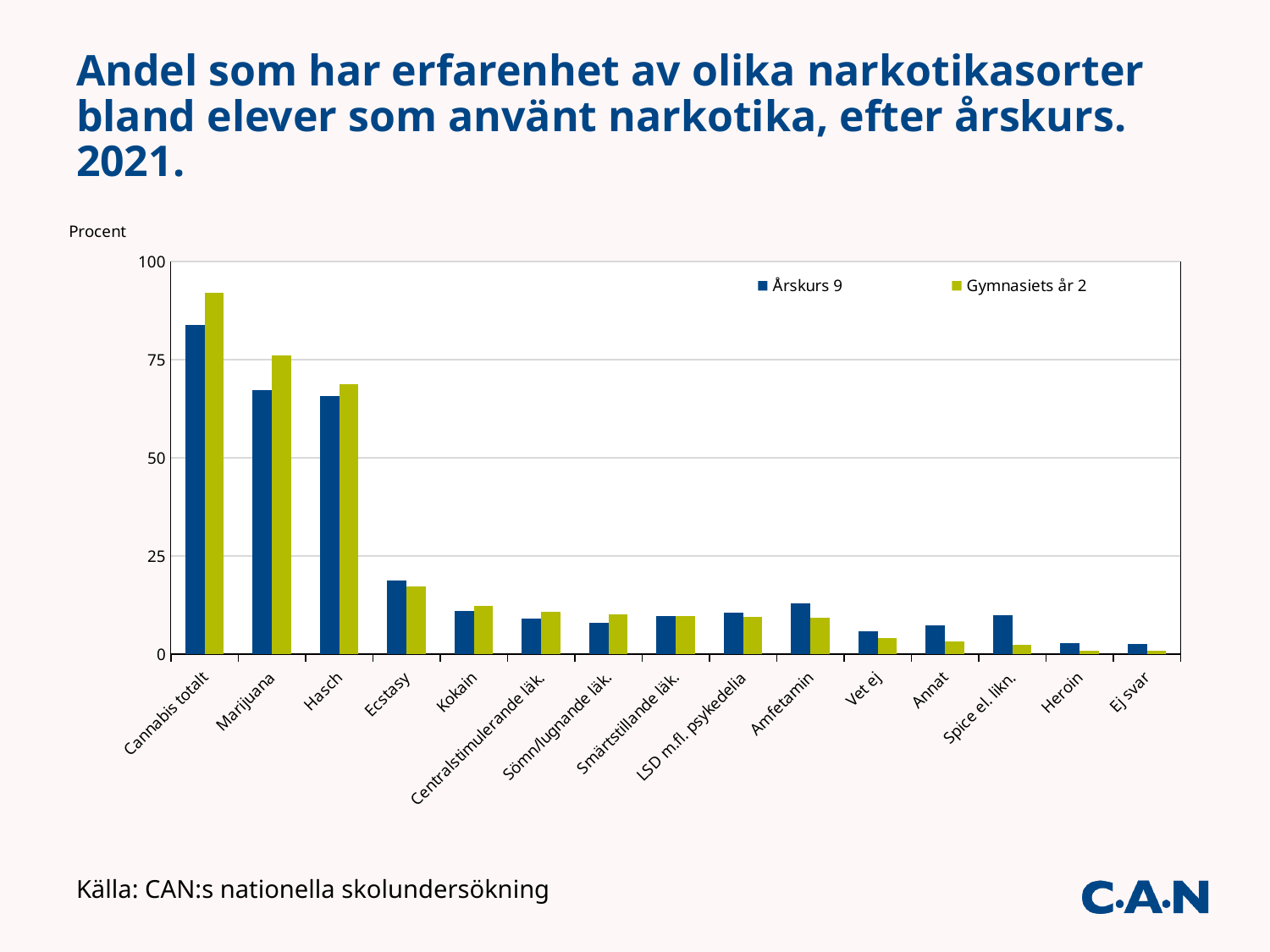
How many categories are shown on the x axis? 15 Which category has the highest value for Årskurs 9? Cannabis totalt What kind of chart is shown on the slide? bar chart Is the value for Cannabis totalt for Gymnasiets år 2 greater or less than 75? greater Is the value for Ecstasy for Årskurs 9 greater or less than 25? less For Marijuana, which series has the larger value, Årskurs 9 or Gymnasiets år 2? Gymnasiets år 2 Is the value for Marijuana for Årskurs 9 greater or less than 75? less What is the label on the vertical axis of the chart? Procent Do the values generally rise or fall from left to right along the x axis? fall Which category has the highest value for Gymnasiets år 2? Cannabis totalt How many series does the legend list? 2 For Spice el. likn., which series has the larger value, Årskurs 9 or Gymnasiets år 2? Årskurs 9